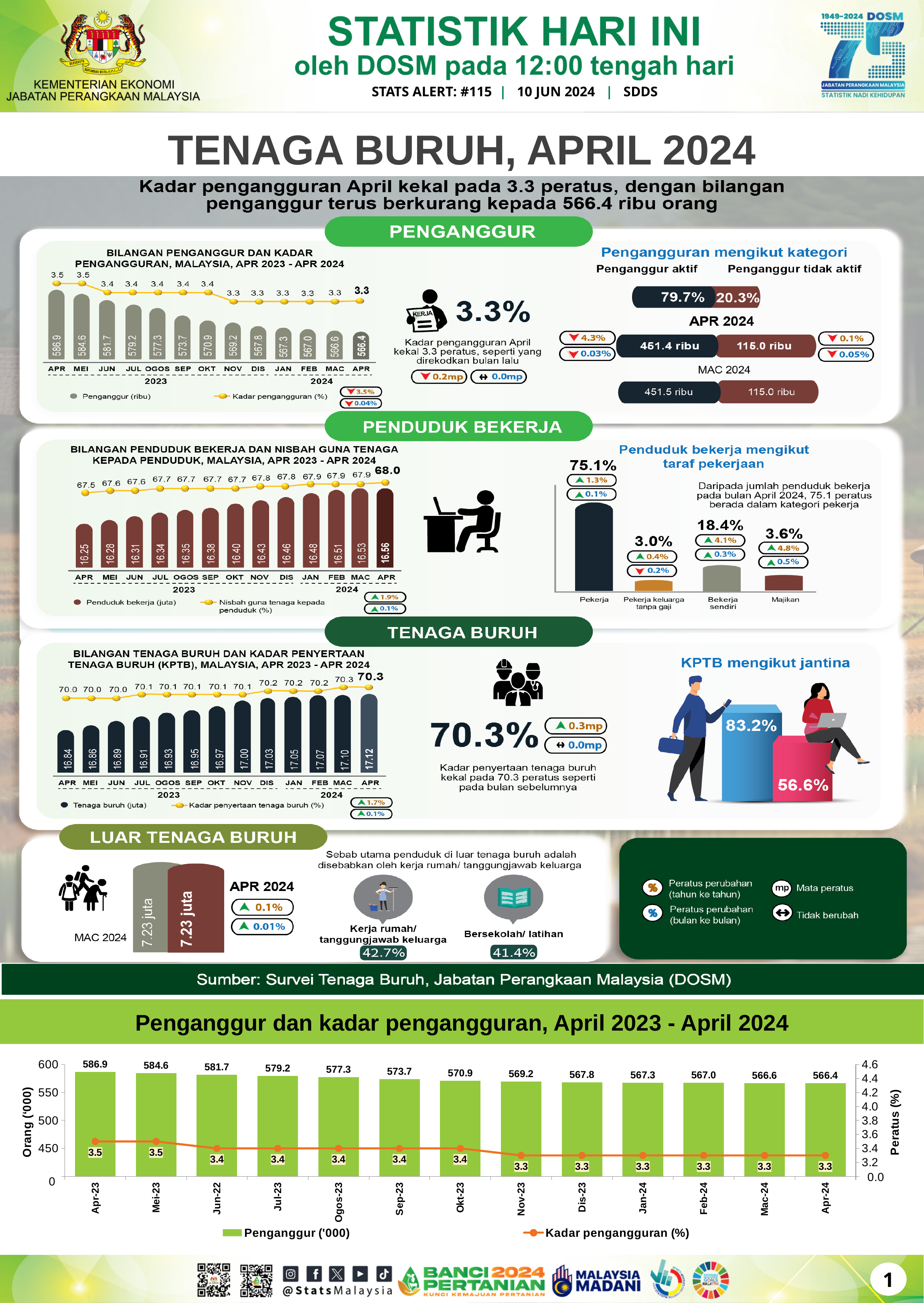
In the bottom chart 'Penganggur dan kadar pengangguran, April 2023 - April 2024', what is the difference in Penganggur ('000) between Apr-23 and Apr-24? 20.5 In the bottom chart 'Penganggur dan kadar pengangguran, April 2023 - April 2024', which month has the highest Penganggur ('000) value? Apr-23 In the bottom chart 'Penganggur dan kadar pengangguran, April 2023 - April 2024', what is the Kadar pengangguran (%) for Okt-23? 3.4 In the chart 'Bilangan tenaga buruh dan kadar penyertaan tenaga buruh (KPTB), Malaysia, Apr 2023 - Apr 2024', what is the Tenaga buruh (juta) value for APR 2024? 17.12 In the chart 'Penduduk bekerja mengikut taraf pekerjaan', which category has the lowest value? Pekerja keluarga tanpa gaji In the bottom chart 'Penganggur dan kadar pengangguran, April 2023 - April 2024', how many months are plotted on the x axis? 13 In the bottom chart 'Penganggur dan kadar pengangguran, April 2023 - April 2024', how many series does the legend list? 2 In the bottom chart 'Penganggur dan kadar pengangguran, April 2023 - April 2024', what is the value of Penganggur ('000) for Apr-24? 566.4 In the bottom chart 'Penganggur dan kadar pengangguran, April 2023 - April 2024', do the Penganggur ('000) values rise or fall from Apr-23 to Apr-24? fall In the chart 'KPTB mengikut jantina', which value is larger, the male 83.2% or the female 56.6%? 83.2% In the chart 'Bilangan penduduk bekerja dan nisbah guna tenaga kepada penduduk, Malaysia, Apr 2023 - Apr 2024', what is the Nisbah guna tenaga kepada penduduk (%) for APR 2024? 68.0 In the chart 'Penduduk bekerja mengikut taraf pekerjaan', what is the value for Bekerja sendiri? 18.4%